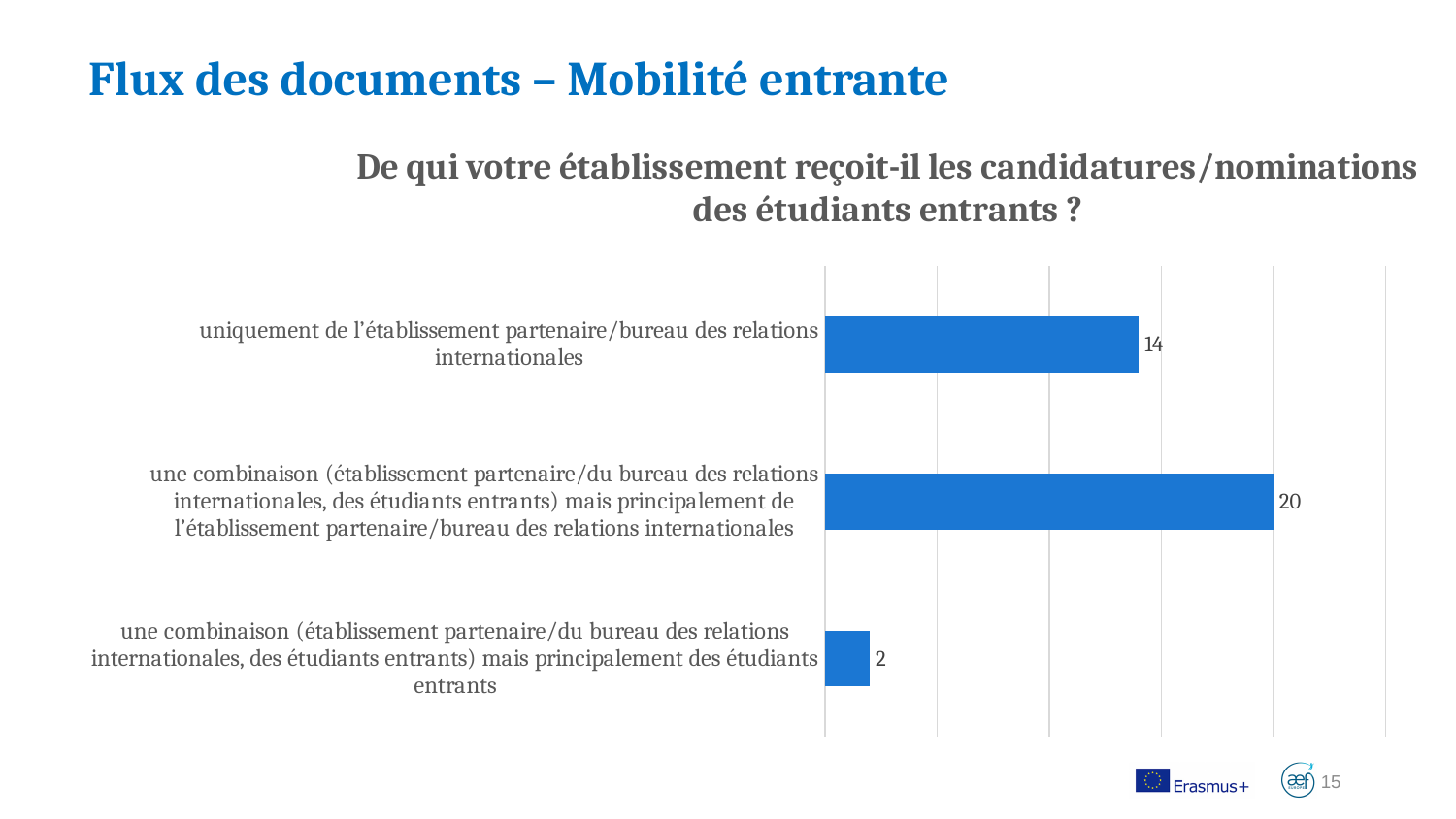
Which category has the highest value? une combinaison (établissement partenaire/du bureau des relations internationales, des étudiants entrants) mais principalement de l'établissement partenaire/bureau des relations internationales What value is shown for the combination option where applications come mainly from incoming students? 2 What is the total of the three values shown in the chart? 36 What value is shown for the combination option where applications come mainly from the partner institution/international relations office? 20 What is the title of the chart? De qui votre établissement reçoit-il les candidatures/nominations des étudiants entrants ? How many categories are shown in the chart? 3 What value is shown for 'uniquement de l'établissement partenaire/bureau des relations internationales'? 14 What is the difference between the value for the combination mainly from the partner institution and the combination mainly from incoming students? 18 What kind of chart is shown on the slide? bar chart Which is larger: the value for 'uniquement de l'établissement partenaire/bureau des relations internationales' or the value for the combination mainly from incoming students? uniquement de l'établissement partenaire/bureau des relations internationales What is the difference between the highest value (20) and the value for 'uniquement de l'établissement partenaire/bureau des relations internationales' (14)? 6 Which category has the lowest value? une combinaison (établissement partenaire/du bureau des relations internationales, des étudiants entrants) mais principalement des étudiants entrants